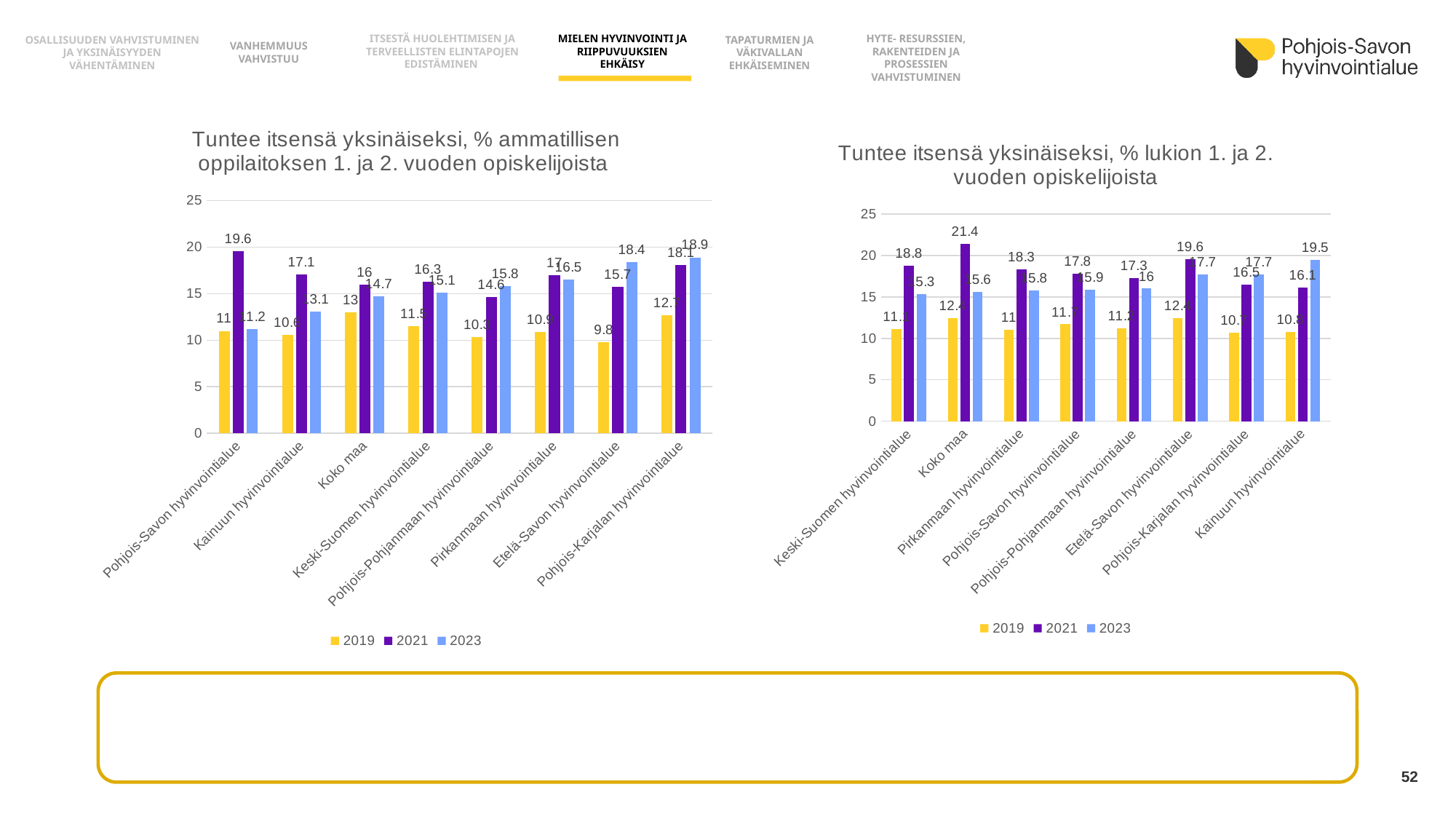
In the left chart (ammatillisen oppilaitoksen), which category has the highest 2023 value? Pohjois-Karjalan hyvinvointialue How many series does the legend of the right chart (lukion) list? 3 In the right chart (lukion), is the 2021 or the 2023 value larger for Kainuun hyvinvointialue? 2023 In the left chart (ammatillisen oppilaitoksen), what is the difference between the 2021 and 2023 values for Pohjois-Savon hyvinvointialue? 8.4 In the right chart (lukion), which category has the lowest 2023 value? Keski-Suomen hyvinvointialue In the left chart (ammatillisen oppilaitoksen), what is the 2021 value for Pohjois-Savon hyvinvointialue? 19.6 How many categories are shown on the x axis of the left chart (ammatillisen oppilaitoksen)? 8 In the left chart (ammatillisen oppilaitoksen), do the 2023 values rise or fall from left to right along the x axis? rise In the right chart (lukion), what is the 2023 value for Kainuun hyvinvointialue? 19.5 What kind of chart is the left chart, 'Tuntee itsensä yksinäiseksi, % ammatillisen oppilaitoksen 1. ja 2. vuoden opiskelijoista'? bar chart In the right chart (lukion), which category has the highest 2021 value? Koko maa In the right chart (lukion), what is the 2021 value for Koko maa? 21.4